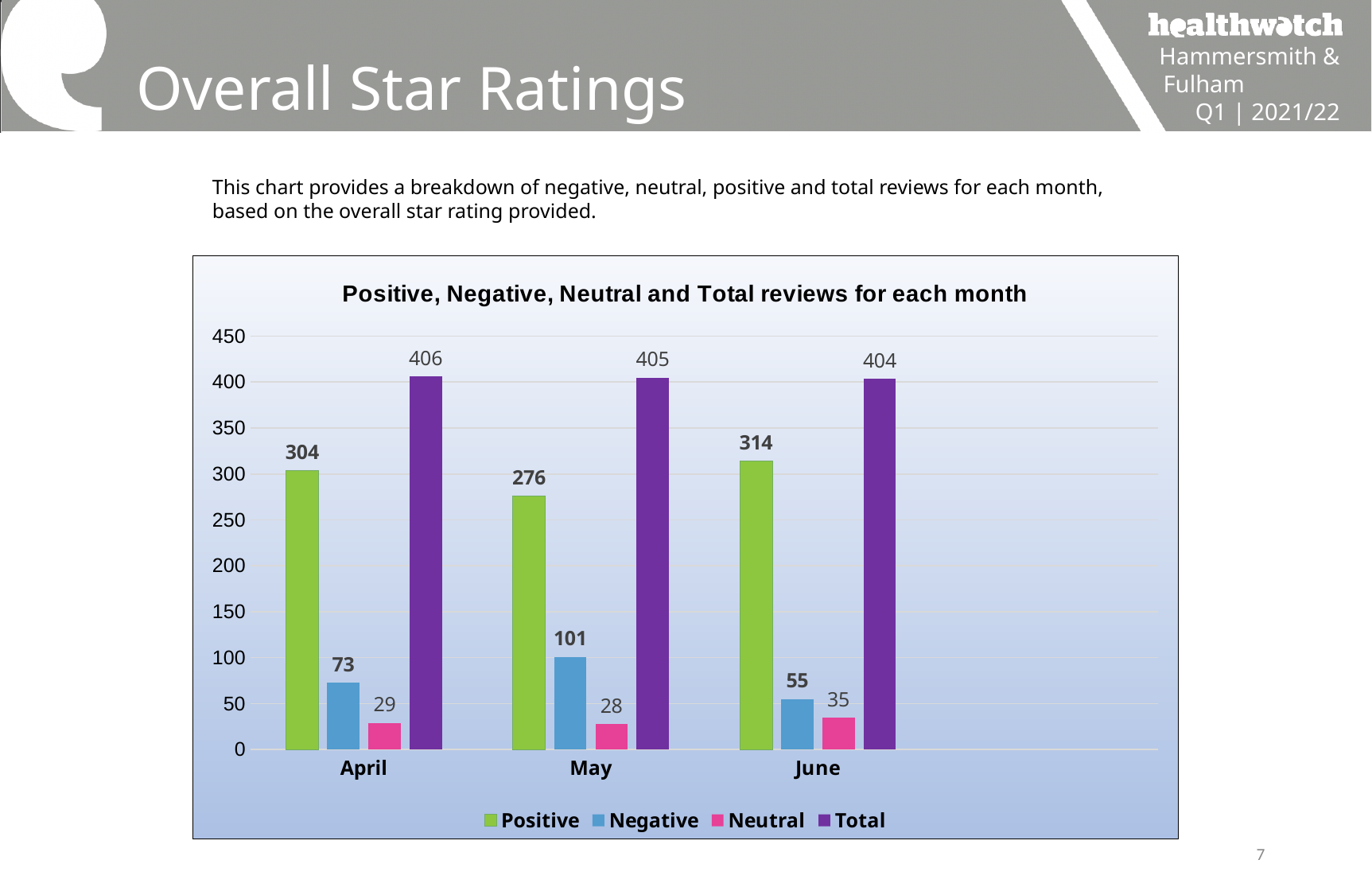
What is the Neutral value for June? 35 What is the Total value for April? 406 What is the number of Negative reviews in May? 101 What is the difference between Positive reviews in June and May? 38 What kind of chart is shown on the slide? Bar chart Which is larger, the Negative value for April or the Negative value for May? May What is the number of Positive reviews in April? 304 Which month has the lowest number of Negative reviews? June Which month has the highest number of Positive reviews? June How many series does the legend list? 4 How many months are shown on the x axis? 3 What is the title of the chart? Positive, Negative, Neutral and Total reviews for each month